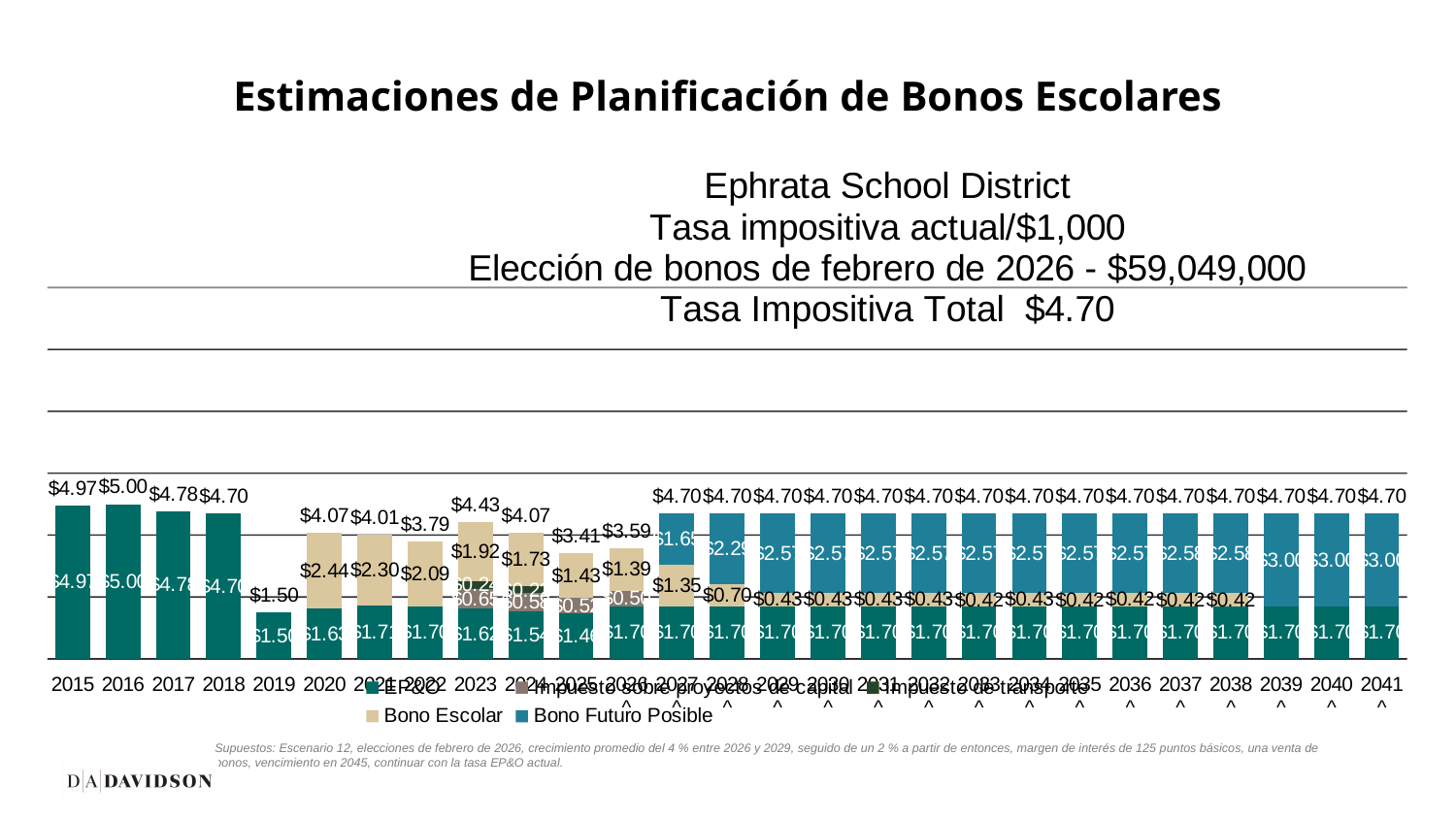
What is the difference between the total tax rates for 2016 and 2019? $3.50 What is the total tax rate shown above the bars from 2027 through 2041? $4.70 Which is larger, the total tax rate for 2022 or for 2023? 2023 What is the total tax rate shown above the bar for 2023? $4.43 What is the total tax rate shown above the bar for 2019? $1.50 Which year has the lowest total tax rate in the chart? 2019 What type of chart is shown on the slide? Stacked bar chart How many series does the chart legend list? 5 What is the total tax rate shown above the bar for 2016? $5.00 Which year has the highest total tax rate in the chart? 2016 What is the Bono Futuro Posible value for 2041? $3.00 What is the Bono Escolar value for 2020? $2.44